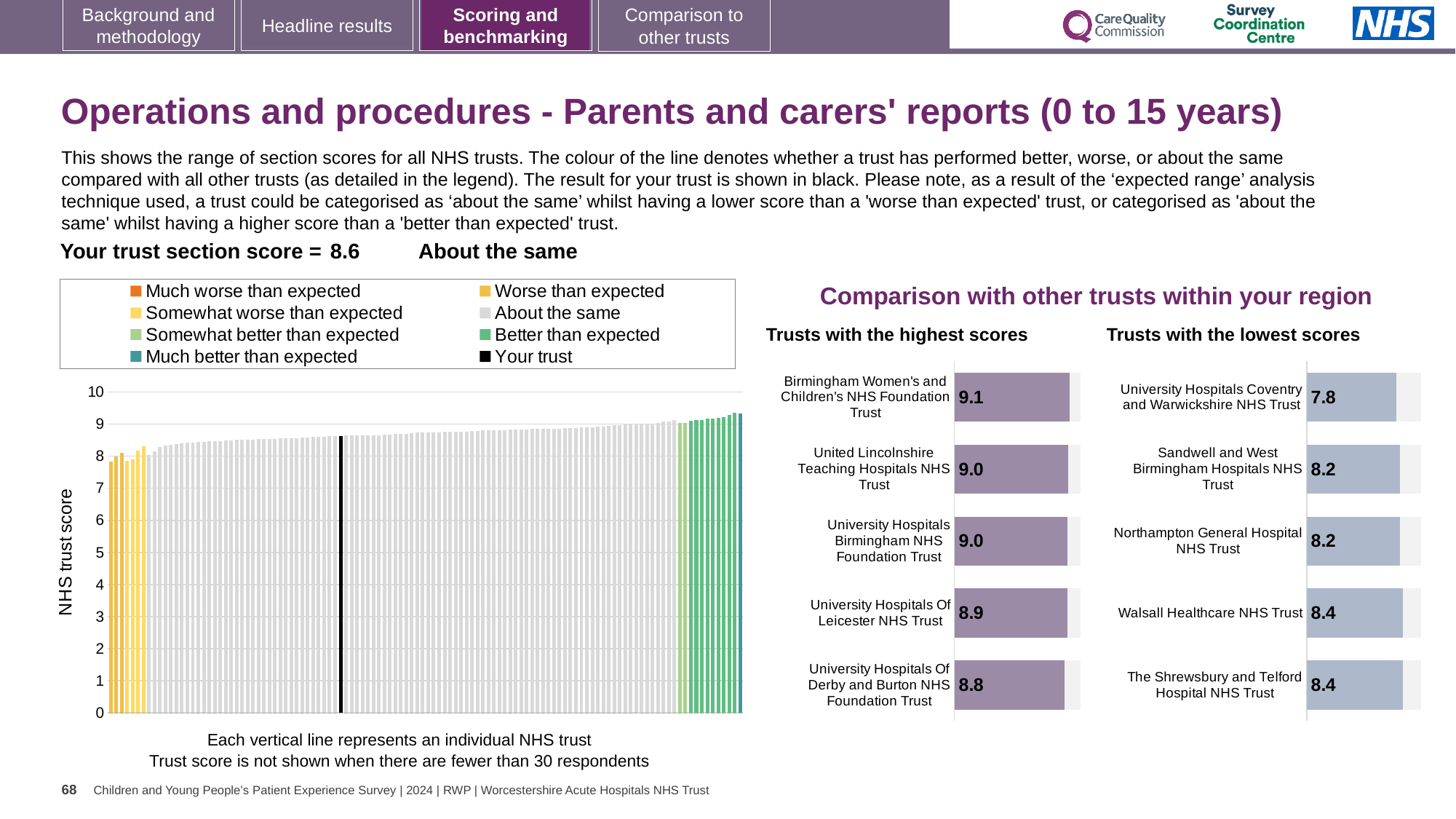
In the 'Trusts with the lowest scores' chart, which has the larger score: Sandwell and West Birmingham Hospitals NHS Trust or Walsall Healthcare NHS Trust? Walsall Healthcare NHS Trust In the 'Trusts with the lowest scores' chart, what is the score for University Hospitals Coventry and Warwickshire NHS Trust? 7.8 In the 'Trusts with the lowest scores' chart, which trust has the lowest score? University Hospitals Coventry and Warwickshire NHS Trust In the 'Trusts with the highest scores' chart, what is the difference between the scores of Birmingham Women's and Children's NHS Foundation Trust and University Hospitals Of Derby and Burton NHS Foundation Trust? 0.3 What kind of chart is the large chart on the left with the y axis labelled 'NHS trust score'? bar chart In the large chart on the left, do the trust scores rise or fall from left to right along the x axis? rise How many trusts are shown in the 'Trusts with the highest scores' chart? 5 In the large chart on the left, what is the section score for your trust (the black bar)? 8.6 In the large chart on the left, is the value for your trust (the black bar) greater or less than 8? greater In the 'Trusts with the highest scores' chart, what is the score for Birmingham Women's and Children's NHS Foundation Trust? 9.1 In the 'Trusts with the highest scores' chart, which trust has the highest score? Birmingham Women's and Children's NHS Foundation Trust How many entries does the legend above the large chart on the left list? 8